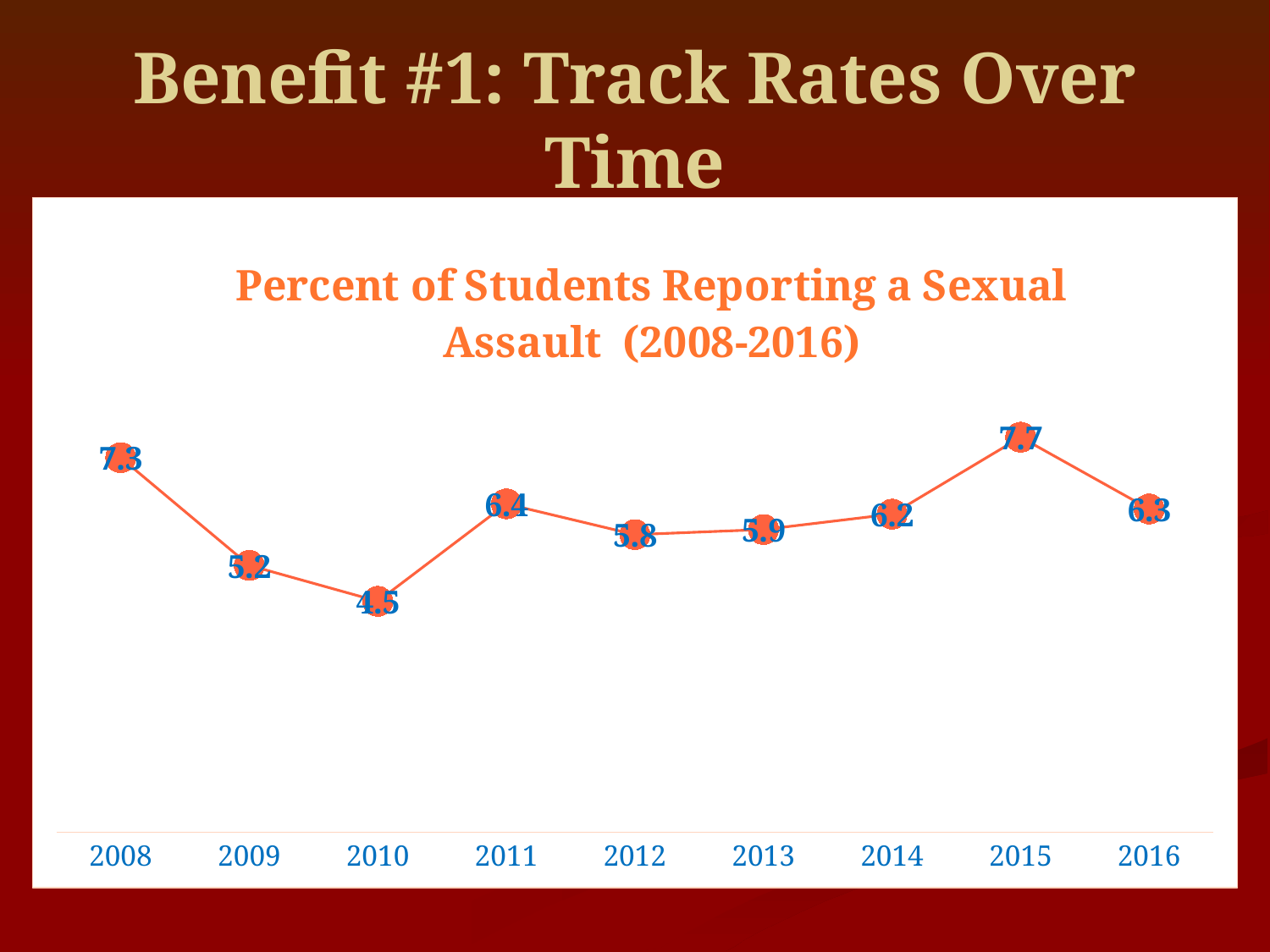
What is the title of the chart? Percent of Students Reporting a Sexual Assault (2008-2016) Which is larger, the value for 2011 or the value for 2014? 2011 What is the value for 2015? 7.7 How many years are plotted on the chart? 9 What is the value for 2008? 7.3 What is the difference between the values for 2008 and 2009? 2.1 What is the difference between the values for 2015 and 2010? 3.2 Which year has the highest value? 2015 Which year has the lowest value? 2010 What is the value for 2016? 6.3 What is the value for 2010? 4.5 What kind of chart is shown? line chart